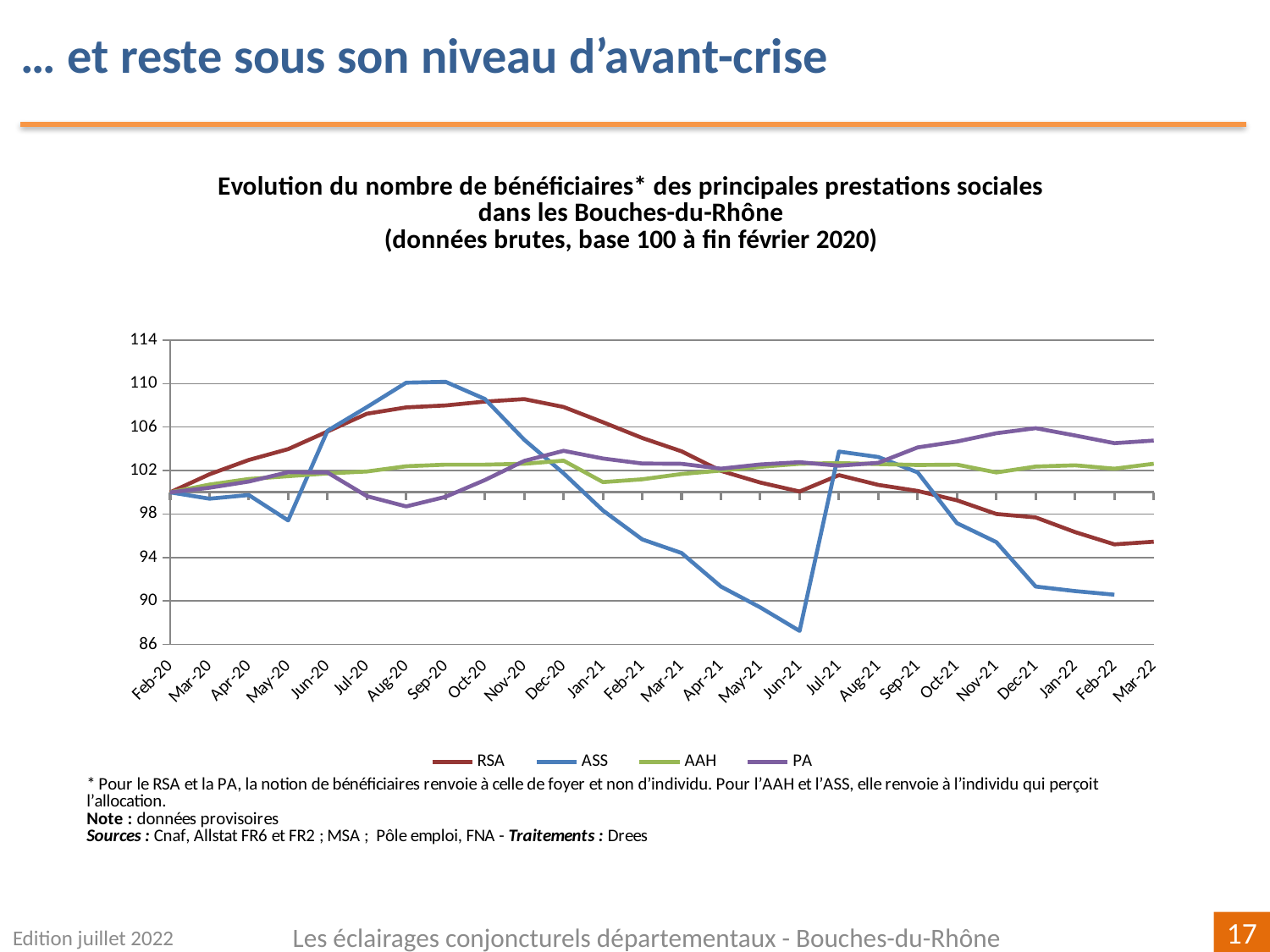
Is the value for ASS in Aug-20 greater or less than 106? greater Is the value for ASS in Jun-21 greater or less than 90? less Is the value for RSA in Nov-20 greater or less than 106? greater Which series is drawn in blue? ASS In which month does the ASS series reach its lowest value? Jun-21 How many months are plotted along the x axis? 26 What kind of chart is shown on the slide? line chart Does the ASS series rise or fall between Sep-20 and Jun-21? fall Which series has the lowest value in Jun-21? ASS How many series does the legend list? 4